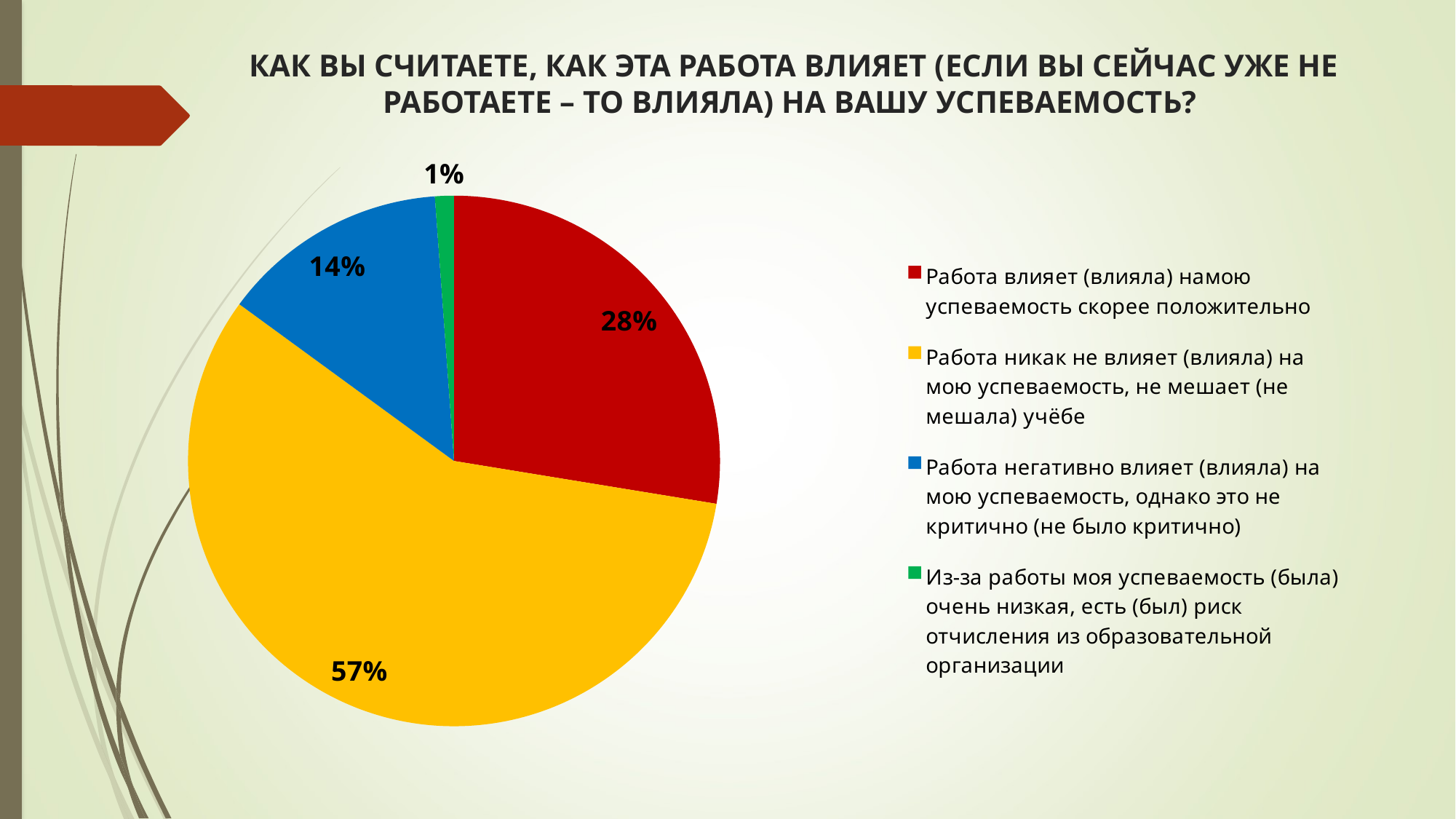
What share of respondents said their performance is very low because of work with a risk of expulsion (Из-за работы моя успеваемость (была) очень низкая)? 1% How many entries does the legend list? 4 What share of respondents said work does not affect their academic performance at all (Работа никак не влияет (влияла) на мою успеваемость)? 57% Which response has the largest share of the pie? Работа никак не влияет (влияла) на мою успеваемость, не мешает (не мешала) учёбе Which is larger: the share saying work affects performance rather positively, or the share saying work negatively affects performance but not critically? Работа влияет (влияла) на мою успеваемость скорее положительно What share of respondents said work negatively affects their performance but not critically (Работа негативно влияет (влияла) на мою успеваемость, однако это не критично)? 14% What is the difference in percentage points between the 'no effect' slice (57%) and the 'rather positive' slice (28%)? 29 How many slices does the pie chart have? 4 What kind of chart is shown on the slide? pie chart What colour is the slice representing 57%? yellow What share of respondents said work affects their academic performance rather positively (Работа влияет (влияла) на мою успеваемость скорее положительно)? 28% Which response has the smallest share of the pie? Из-за работы моя успеваемость (была) очень низкая, есть (был) риск отчисления из образовательной организации